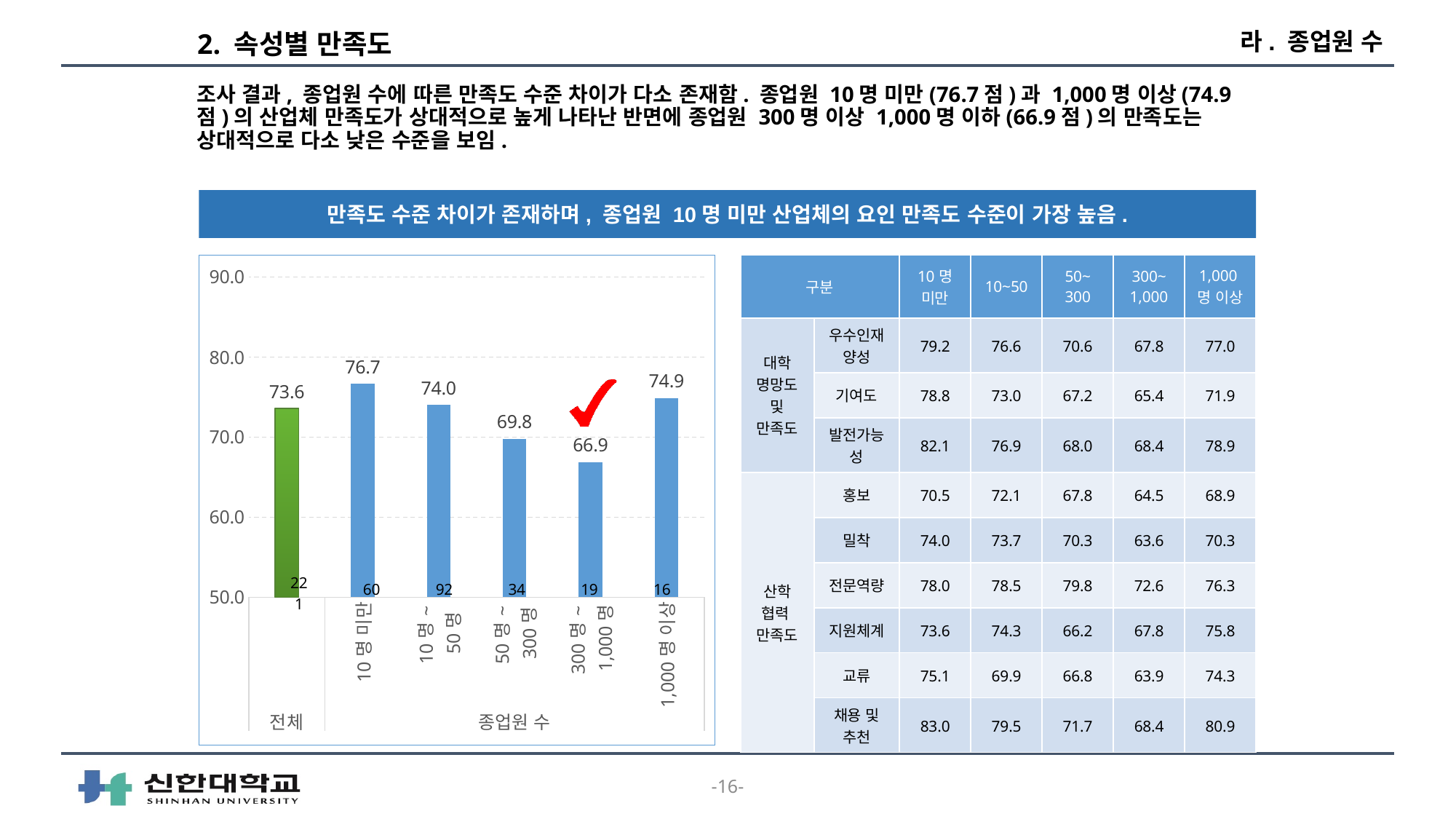
What is the satisfaction score shown for the 10명 미만 category? 76.7 What kind of chart is shown on the slide? bar chart What is the value shown for the 300명~1,000명 category? 66.9 How many bars are plotted in the chart? 6 What colour is the 전체 bar compared with the 종업원 수 bars? green; the others are blue Among the 종업원 수 categories, which has the highest value? 10명 미만 Is the value for 50명~300명 greater or less than 70.0? less Which is larger, the value for 10명~50명 or the value for 50명~300명? 10명~50명 What is the difference between the values for 10명 미만 and 300명~1,000명? 9.8 What is the value shown for the 1,000명 이상 category? 74.9 What is the value shown for the 전체 bar? 73.6 Among the 종업원 수 categories, which has the lowest value? 300명~1,000명